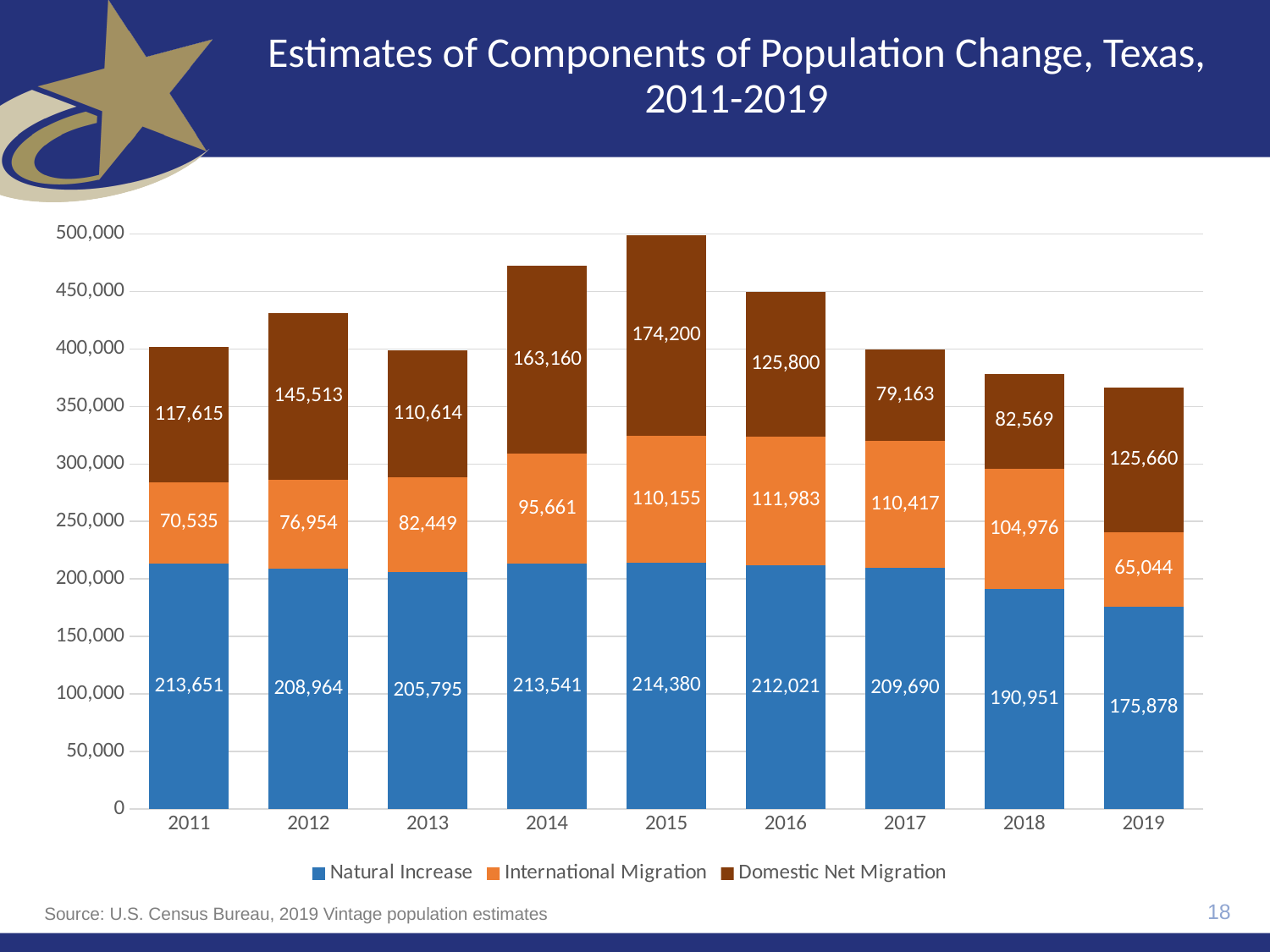
Is the total height of the 2015 stacked bar greater or less than 450,000? greater What is the International Migration value for 2018? 104,976 Which is larger, the Natural Increase value for 2011 or for 2019? 2011 What kind of chart is shown on the slide? Stacked bar chart Which year has the lowest International Migration value? 2019 What is the Natural Increase value for 2014? 213,541 How many series does the legend list? 3 What is the total of the stacked bar for 2019? 366,582 Which year has the highest Domestic Net Migration value? 2015 What is the Domestic Net Migration value for 2012? 145,513 How many years are shown on the x axis? 9 What is the difference between the Domestic Net Migration values for 2015 and 2017? 95,037